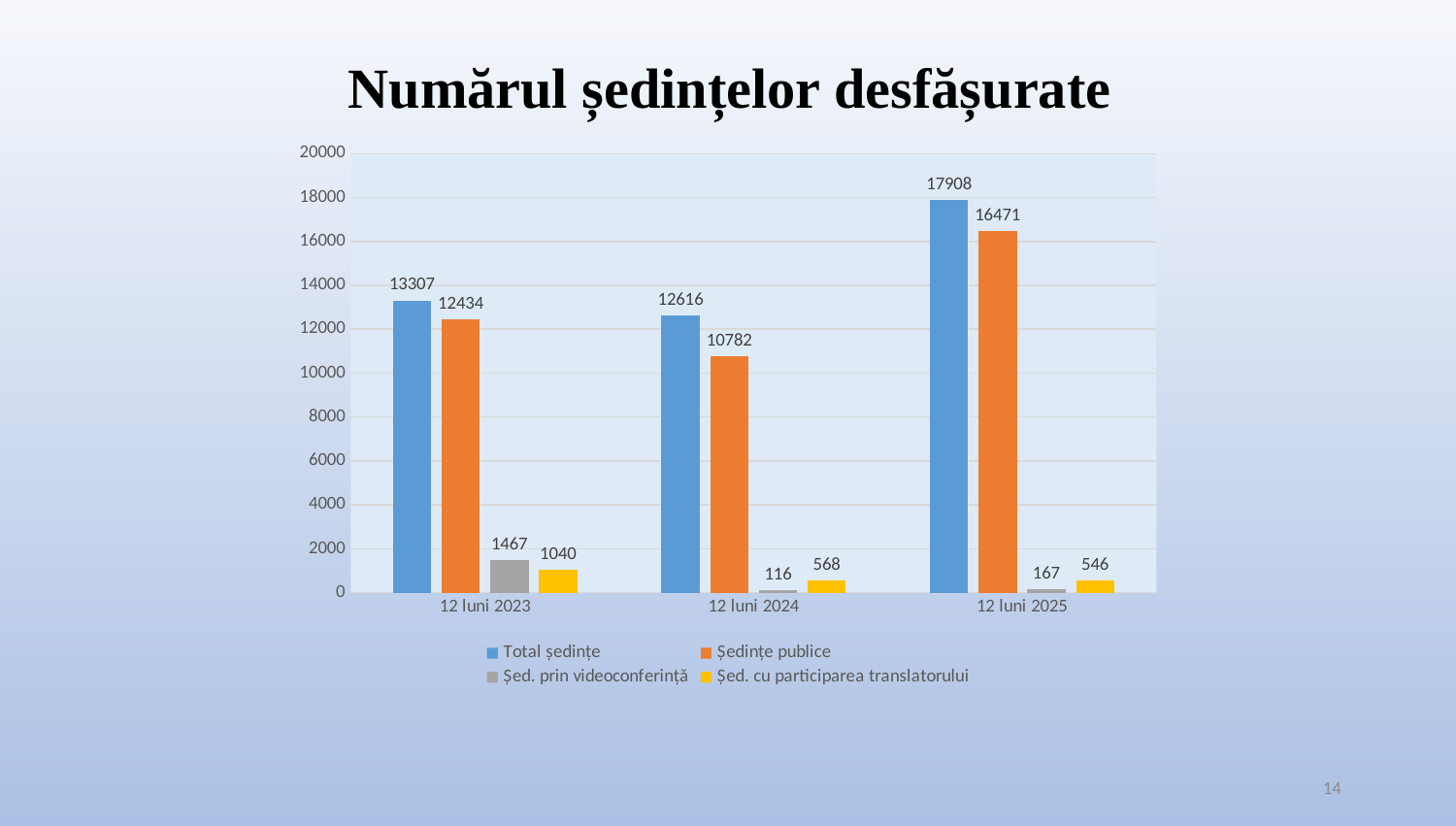
Which is larger: Șed. cu participarea translatorului for 12 luni 2024 or for 12 luni 2025? 12 luni 2024 What is the difference between Total ședințe and Ședințe publice for 12 luni 2023? 873 What is the value of Ședințe publice for 12 luni 2024? 10782 Which period has the highest value for Total ședințe? 12 luni 2025 What kind of chart is shown on the slide? Bar chart What is the value of Șed. cu participarea translatorului for 12 luni 2025? 546 What is the value of Șed. prin videoconferință for 12 luni 2023? 1467 Which period has the lowest value for Șed. prin videoconferință? 12 luni 2024 How many series does the legend list? 4 What is the title of the chart? Numărul ședințelor desfășurate What is the value of Total ședințe for 12 luni 2025? 17908 How many periods are shown on the x axis? 3